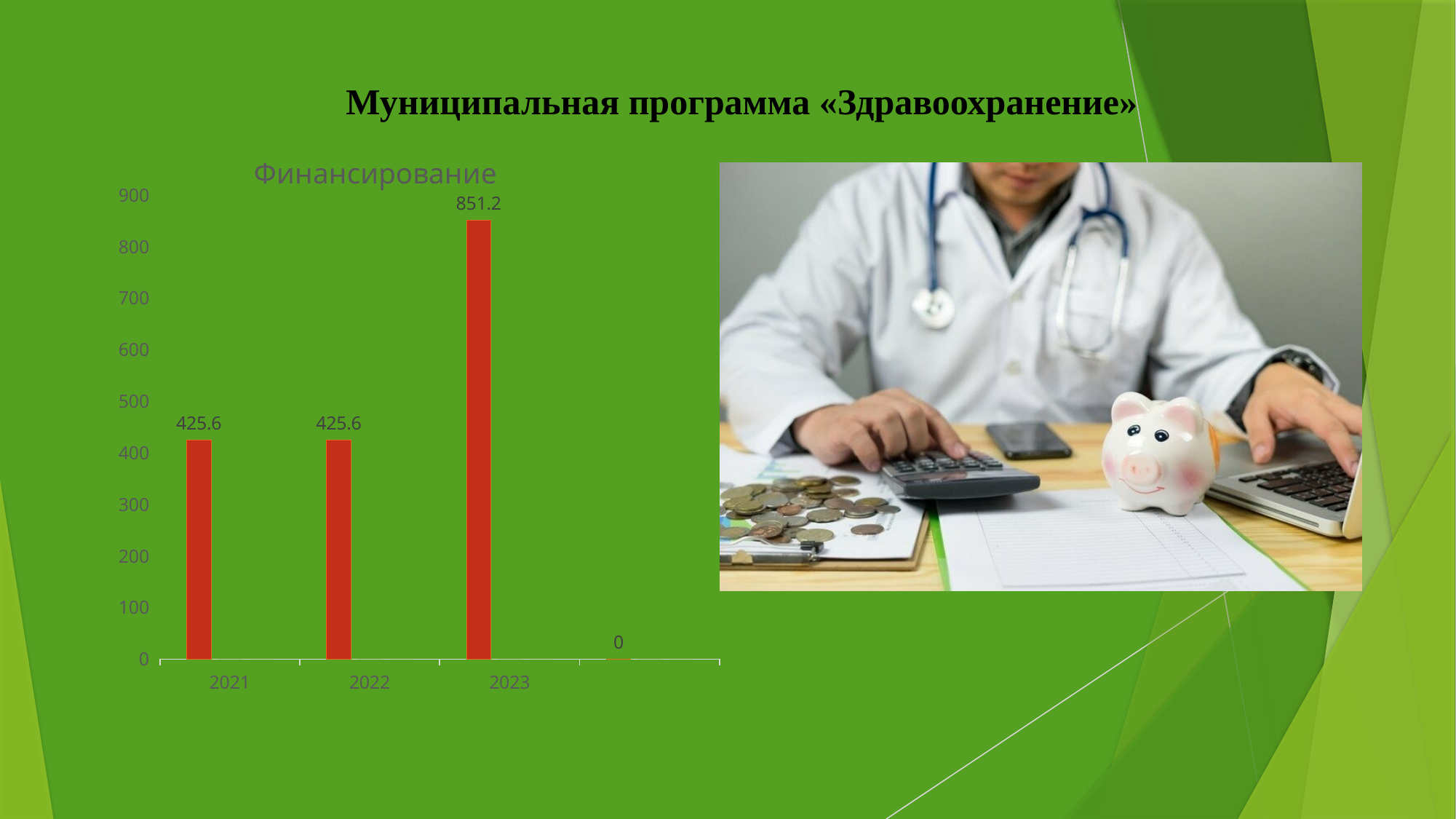
Is the value for 2023 in the Финансирование chart greater or less than 800? greater What is the value for 2021 in the Финансирование chart? 425.6 Is the value for 2021 in the Финансирование chart greater or less than 500? less What is the value for 2023 in the Финансирование chart? 851.2 What is the value for 2022 in the Финансирование chart? 425.6 What is the difference between the values for 2023 and 2022 in the Финансирование chart? 425.6 Which is larger in the Финансирование chart, the value for 2021 or the value for 2023? 2023 How many years are labeled on the x axis of the Финансирование chart? 3 What is the title of the chart on the slide? Финансирование Do the values in the Финансирование chart rise or fall from 2021 to 2023? rise Which year has the highest value in the Финансирование chart? 2023 What kind of chart is shown on the slide? bar chart